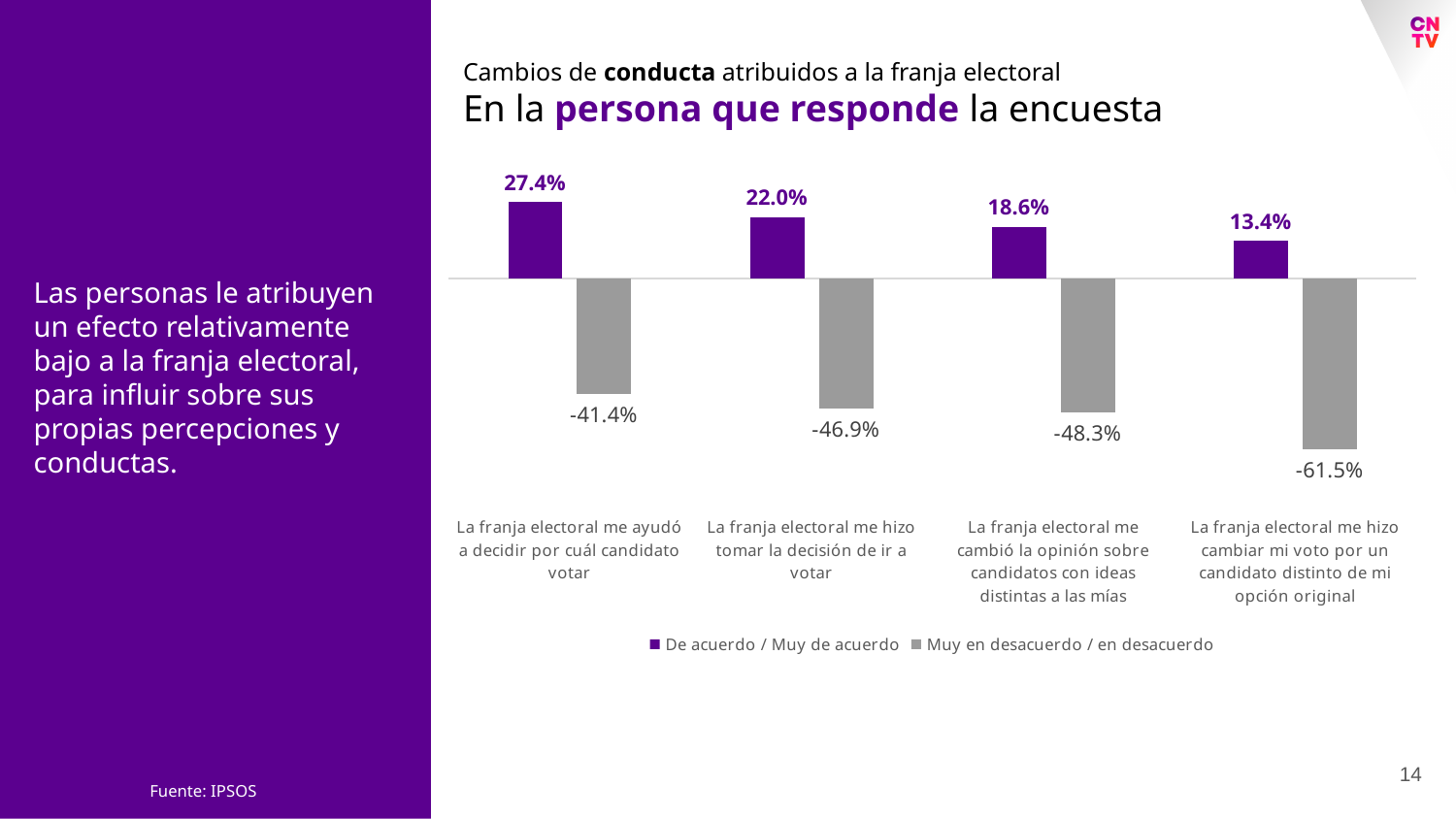
What type of chart is shown on the slide? Bar chart Which statement has the highest 'De acuerdo / Muy de acuerdo' percentage? La franja electoral me ayudó a decidir por cuál candidato votar Which statement has the lowest 'De acuerdo / Muy de acuerdo' percentage? La franja electoral me hizo cambiar mi voto por un candidato distinto de mi opción original What percentage of respondents agree (De acuerdo / Muy de acuerdo) that the franja electoral helped them decide which candidate to vote for? 27.4% How many statements (categories) are shown on the x axis of the chart? 4 What is the 'Muy en desacuerdo / en desacuerdo' value for 'La franja electoral me hizo cambiar mi voto por un candidato distinto de mi opción original'? -61.5% Do the 'De acuerdo / Muy de acuerdo' values rise or fall from left to right across the statements? Fall Which is larger in magnitude: the disagreement for 'La franja electoral me ayudó a decidir por cuál candidato votar' or for 'La franja electoral me cambió la opinión sobre candidatos con ideas distintas a las mías'? La franja electoral me cambió la opinión sobre candidatos con ideas distintas a las mías What is the 'De acuerdo / Muy de acuerdo' value for 'La franja electoral me cambió la opinión sobre candidatos con ideas distintas a las mías'? 18.6% What is the 'Muy en desacuerdo / en desacuerdo' value for 'La franja electoral me hizo tomar la decisión de ir a votar'? -46.9% What is the difference between the 'De acuerdo / Muy de acuerdo' values for the first statement (27.4%) and the last statement (13.4%)? 14.0% How many series does the chart legend list? 2